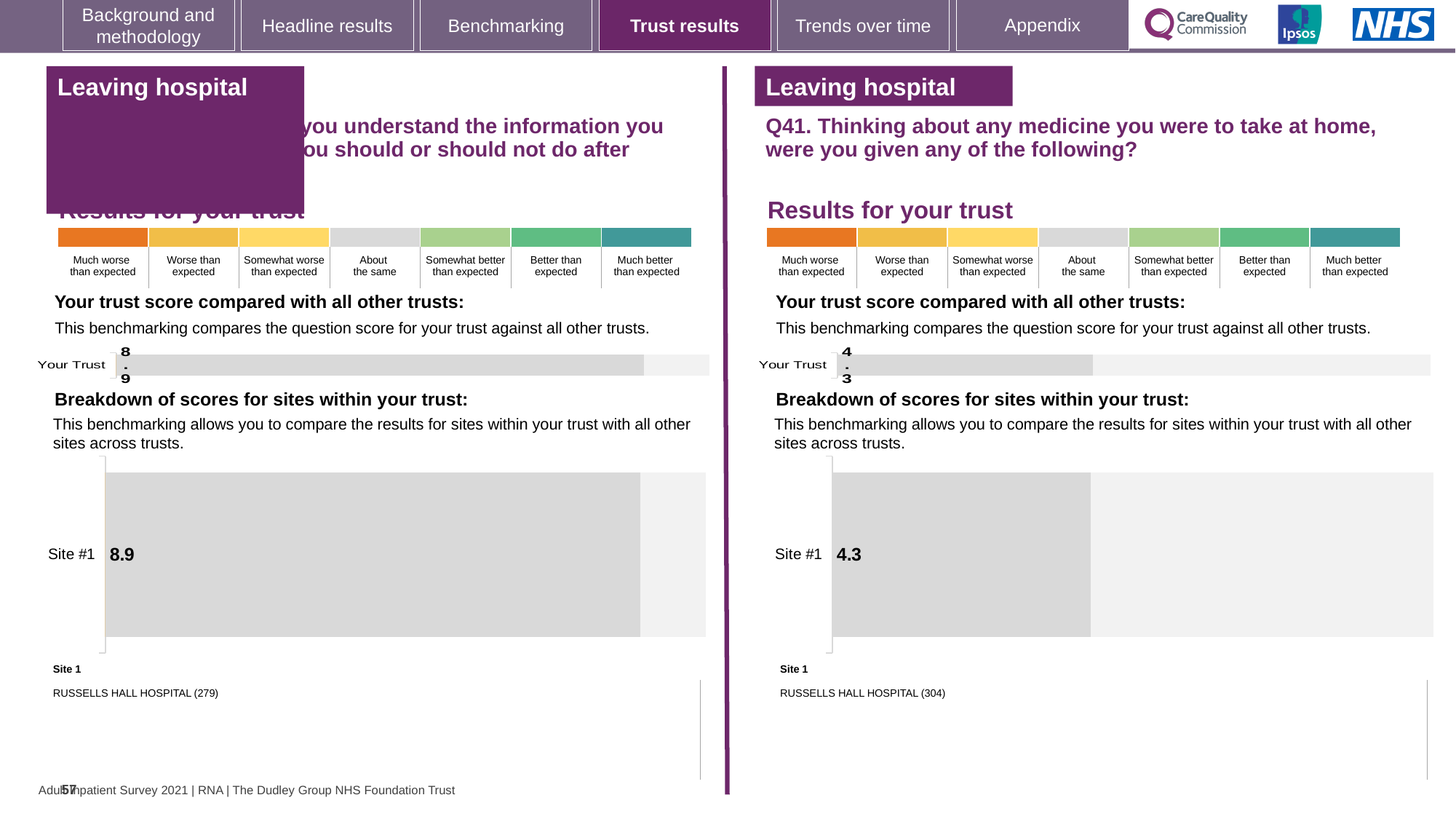
Which hospital is listed as Site 1 on the right-hand (Q41) side? RUSSELLS HALL HOSPITAL On the right-hand (Q41) chart, what is the difference between the Your Trust score and the Site #1 score? 0 Which has the higher Your Trust score: the left-hand chart or the right-hand (Q41) chart? The left-hand chart On the left-hand chart, what is the score shown for Your Trust? 8.9 On the left-hand site breakdown chart, what is the score for Site #1? 8.9 What kind of chart is used to show the Site #1 score on the left-hand side? Bar chart What is the difference between the Your Trust score on the left-hand chart and the Your Trust score on the right-hand (Q41) chart? 4.6 On the right-hand (Q41) site breakdown chart, what is the score for Site #1? 4.3 Which has the higher Site #1 score: the left-hand chart or the right-hand (Q41) chart? The left-hand chart What number is shown in brackets after RUSSELLS HALL HOSPITAL on the left-hand side? 279 On the right-hand (Q41) chart, what is the score shown for Your Trust? 4.3 How many sites are shown in the site breakdown chart on the right-hand (Q41) side? 1